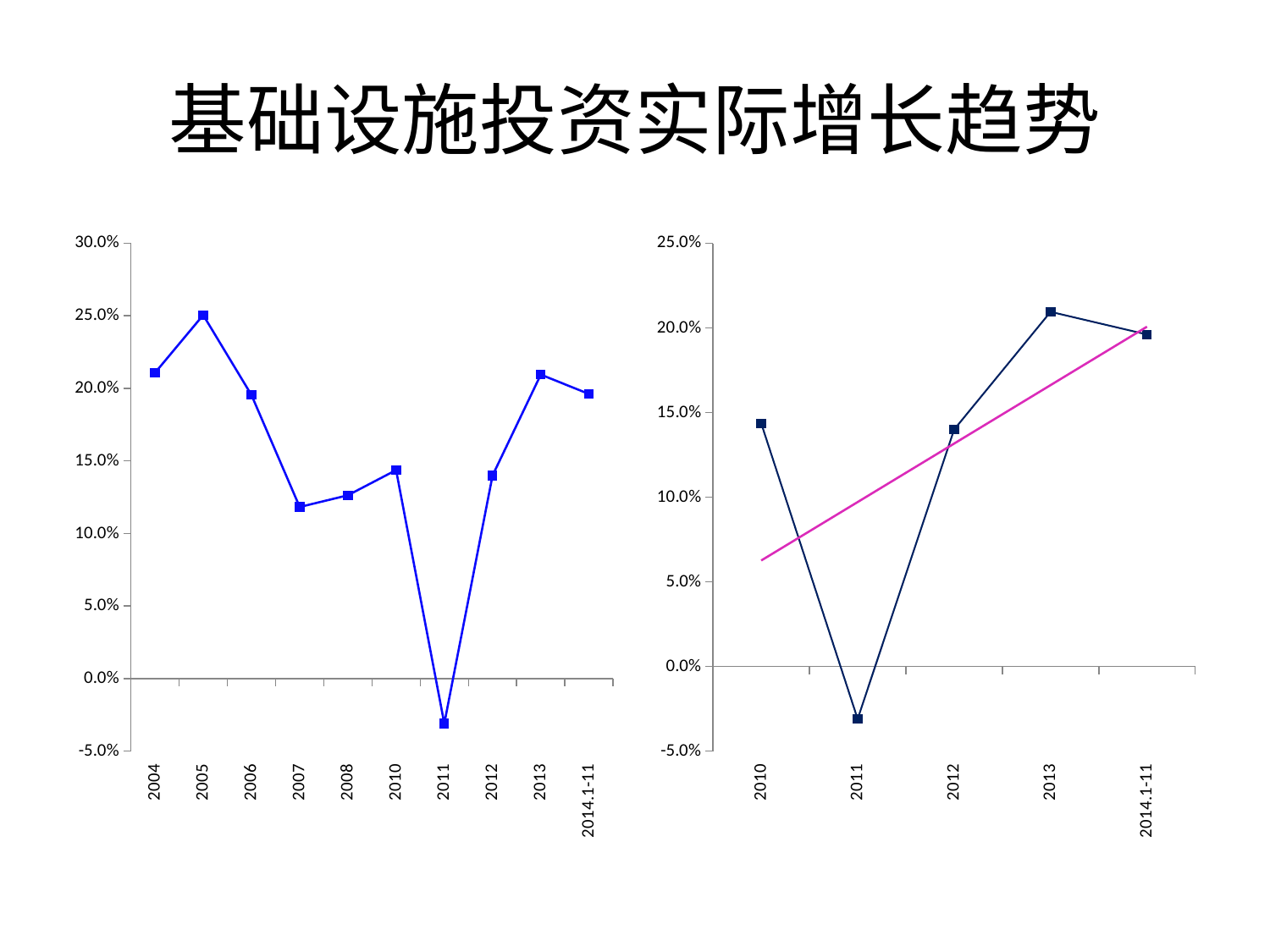
On the left chart, is the value for 2007 greater or less than 15.0%? less On the right chart, is the value for 2013 greater or less than 20.0%? greater What kind of chart is the left chart on the slide? line chart On the right chart, which year has the highest value? 2013 On the left chart, which is larger, the value for 2006 or the value for 2008? 2006 On the left chart, is the value for 2004 greater or less than 20.0%? greater On the left chart, which year has the lowest value? 2011 On the right chart, which year has the lowest value? 2011 How many categories are shown on the x axis of the right chart? 5 How many data points are plotted on the left chart? 10 On the left chart, which year has the highest value? 2005